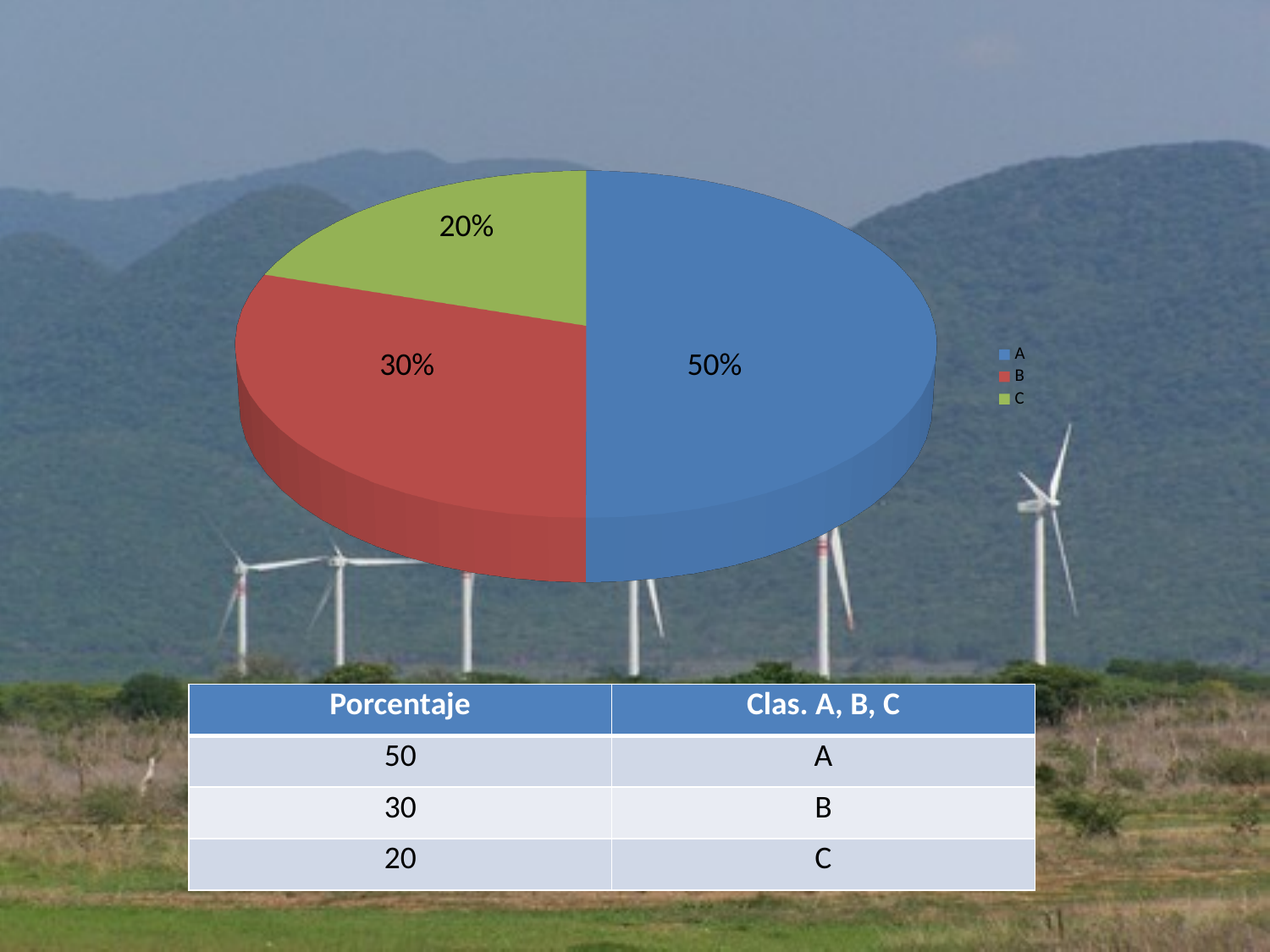
How many slices does the pie chart have? 3 Which category has the largest slice in the pie chart? A What percentage does slice C represent in the pie chart? 20% What percentage does slice A represent in the pie chart? 50% What colour is slice B in the pie chart? red Which category has the smallest slice in the pie chart? C What kind of chart is shown on the slide? pie chart What is the difference in percentage points between slice B and slice C? 10 How many entries does the legend list? 3 Which is larger, slice B or slice C? B What is the difference in percentage points between slice A and slice C? 30 What percentage does slice B represent in the pie chart? 30%